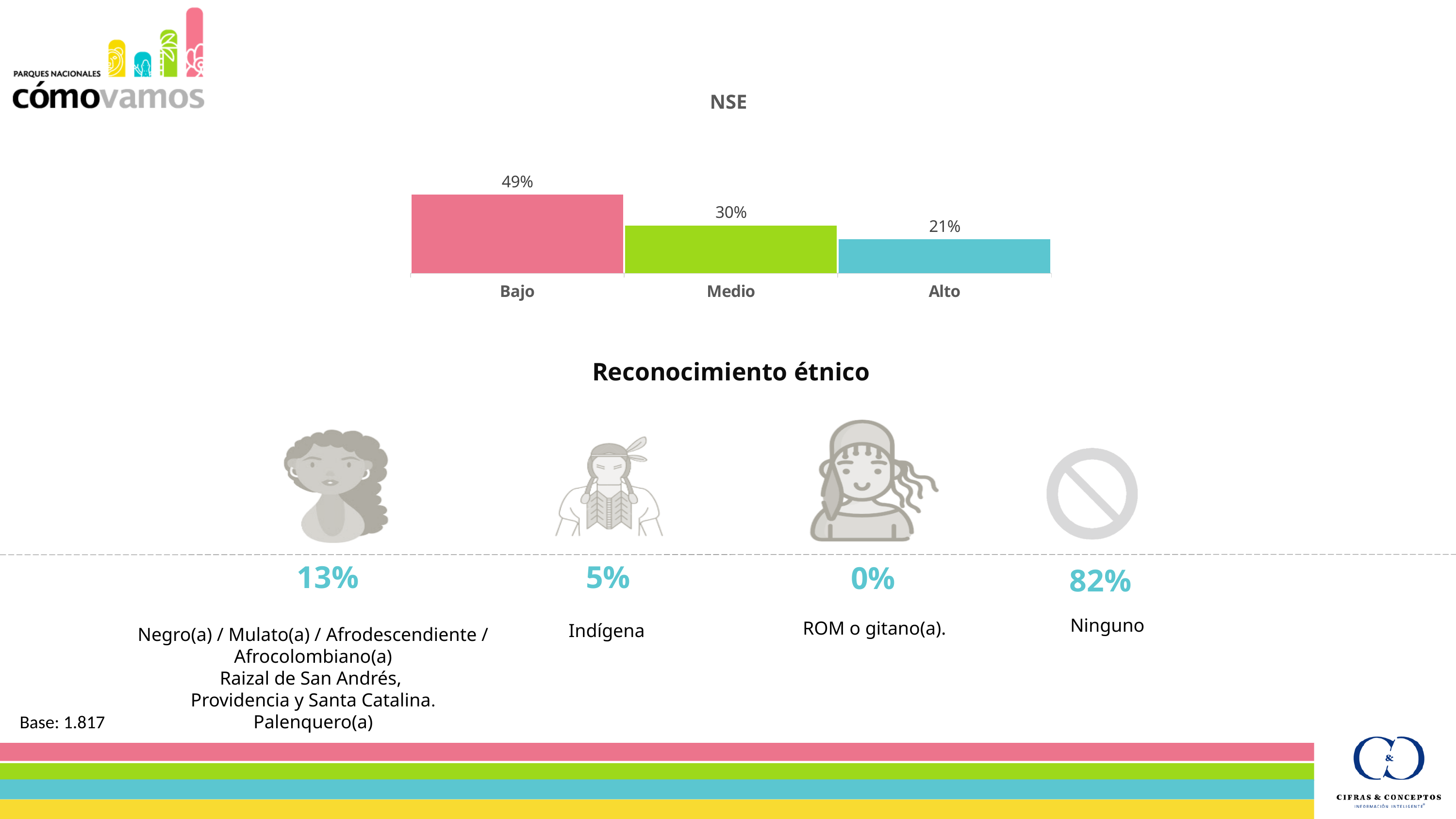
In the NSE chart, do the values rise or fall from Bajo to Alto? fall What kind of chart is the NSE chart? bar chart In the NSE chart, what is the value for Medio? 30% In the NSE chart, what is the value for Bajo? 49% In the NSE chart, what is the value for Alto? 21% In the NSE chart, what colour is the bar for Medio? green In the NSE chart, which category has the lowest value? Alto In the NSE chart, what is the difference between the values for Bajo and Alto? 28% What is the title of the bar chart at the top of the slide? NSE In the NSE chart, which category has the highest value? Bajo How many categories does the NSE chart show? 3 In the NSE chart, which is larger, the value for Medio or the value for Alto? Medio